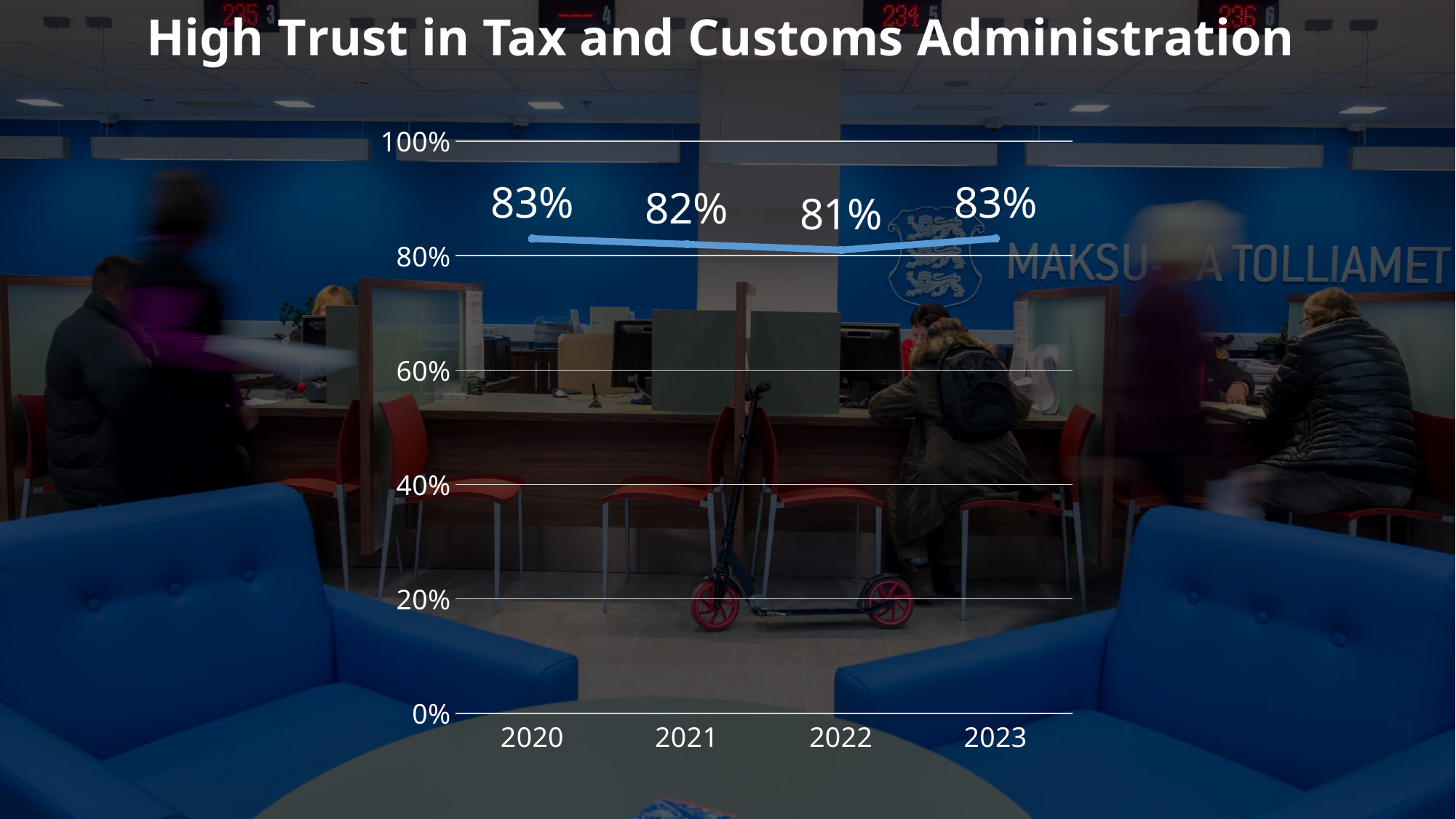
What is the value for 2023? 83% Which is larger, the value for 2021 or the value for 2022? 2021 What is the title of the slide? High Trust in Tax and Customs Administration What is the value for 2022? 81% What is the difference between the values for 2020 and 2022? 2% What is the value for 2021? 82% What is the value for 2020? 83% Which year has the lowest value? 2022 What kind of chart is shown on the slide? line chart Do the values rise or fall from 2020 to 2022? fall Is the value for 2022 greater or less than 80%? greater How many years are shown on the x axis? 4